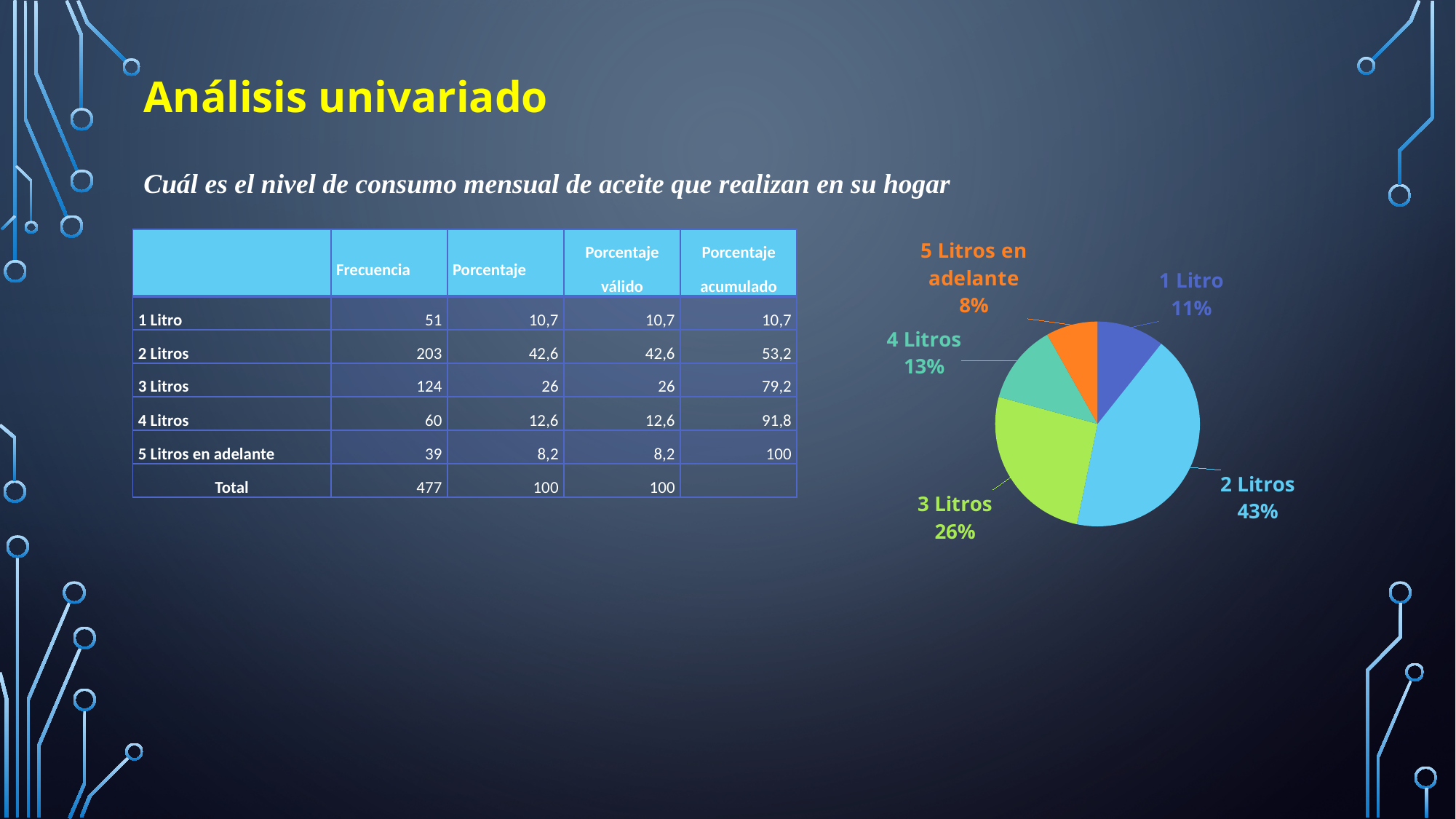
Which category has the smallest slice in the pie chart? 5 Litros en adelante What percentage does the pie chart show for 2 Litros? 43% What percentage does the pie chart show for 1 Litro? 11% Which slice is larger in the pie chart, 4 Litros or 1 Litro? 4 Litros What percentage does the pie chart show for 5 Litros en adelante? 8% What colour is the 3 Litros slice in the pie chart? green What percentage does the pie chart show for 4 Litros? 13% How many slices does the pie chart have? 5 What is the difference in percentage points between the 2 Litros slice and the 3 Litros slice? 17 What is the combined percentage of the 1 Litro and 5 Litros en adelante slices? 19% What kind of chart is shown on the slide? pie chart Which category has the largest slice in the pie chart? 2 Litros